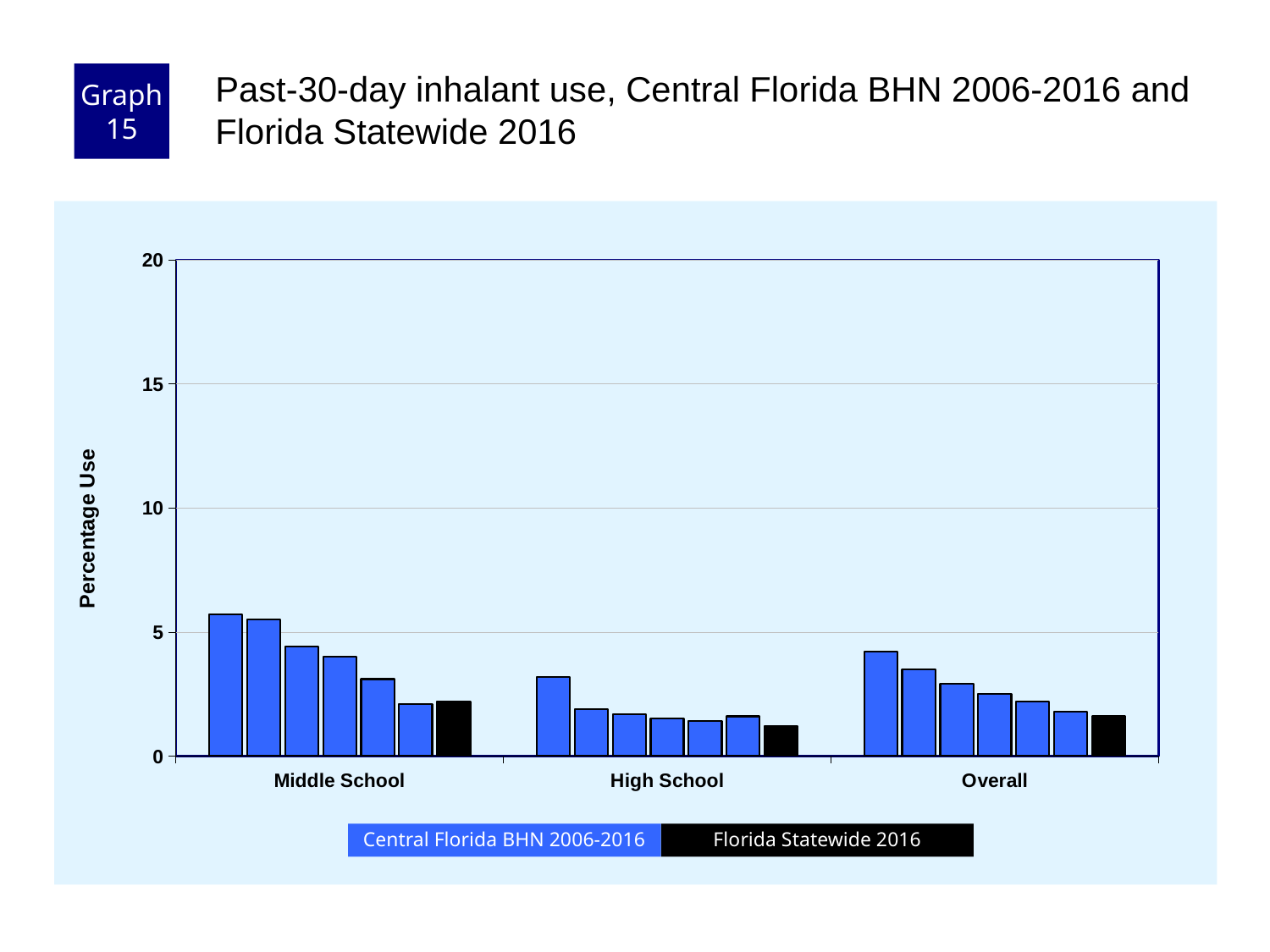
What kind of chart is shown on the slide? bar chart How many entries does the legend list? 2 Which is larger: the first Central Florida BHN bar for Middle School or the first Central Florida BHN bar for High School? Middle School Do the Central Florida BHN bars for Middle School rise or fall from left to right? fall What is the label of the y axis? Percentage Use Which colour represents Florida Statewide 2016 in the legend? black How many school-level categories are shown on the x axis? 3 Are any bars on the chart greater than 10? no Is the tallest Middle School bar greater or less than 5? greater Is the tallest Overall bar greater or less than 5? less Which category has the tallest bar overall: Middle School, High School, or Overall? Middle School